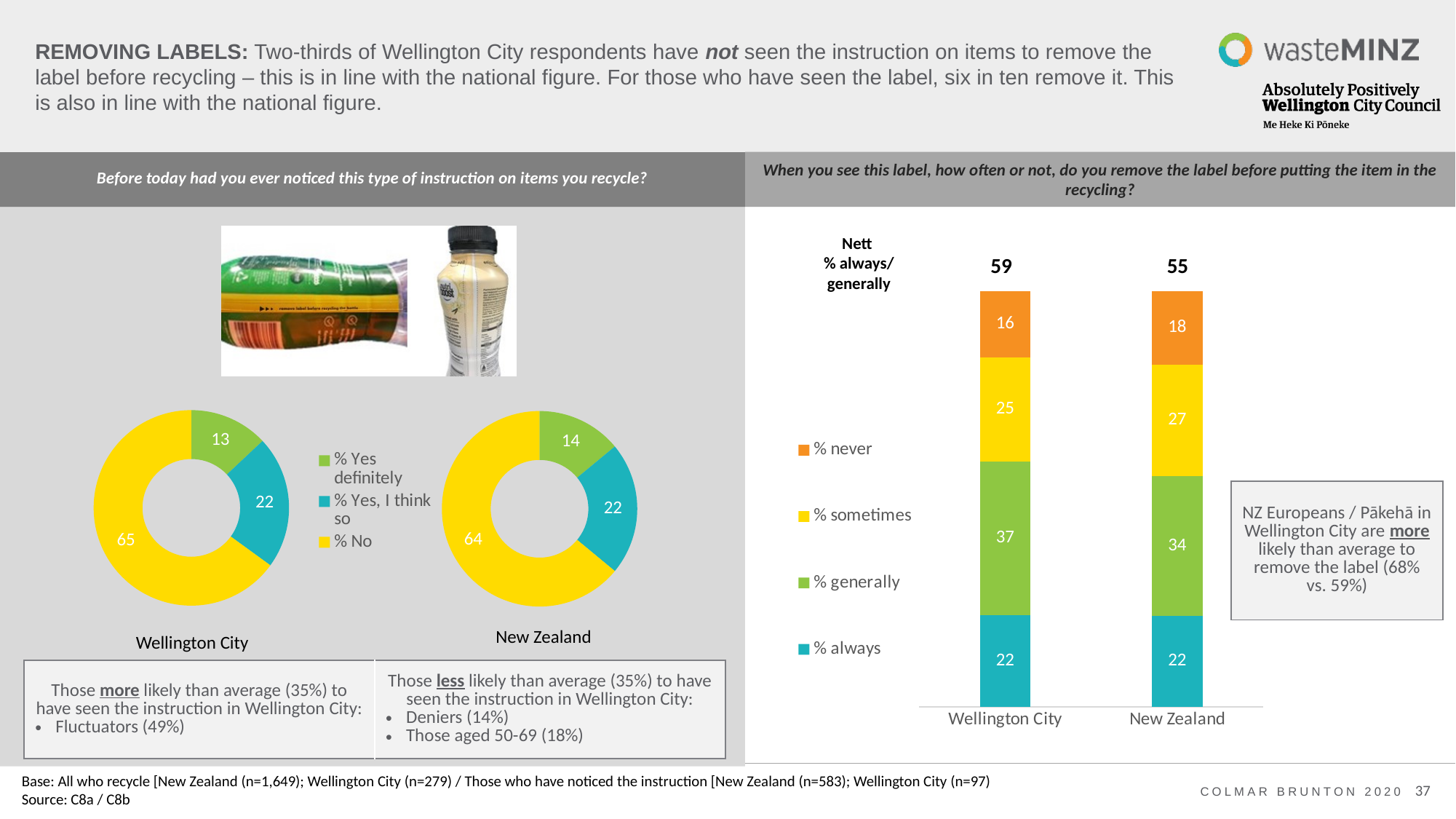
How many series does the legend of the stacked bar chart on the right list? 4 In the stacked bar chart on the right, which has the larger % sometimes value, Wellington City or New Zealand? New Zealand In the New Zealand donut chart on the left, what is the value for % Yes definitely? 14 How many categories are shown on the x axis of the stacked bar chart on the right? 2 In the Wellington City donut chart on the left, what is the value for % No? 65 In the Wellington City donut chart on the left, which category has the largest slice? % No What kind of chart is shown on the right side of the slide? Stacked bar chart In the stacked bar chart on the right, which segment of the Wellington City bar is the smallest? % never What are the three legend entries for the donut charts on the left? % Yes definitely, % Yes, I think so, % No In the stacked bar chart on the right, what is the difference between the % generally values for Wellington City and New Zealand? 3 In the stacked bar chart on the right, what is the % never value for New Zealand? 18 In the stacked bar chart on the right, what is the Nett % always/generally figure for Wellington City? 59